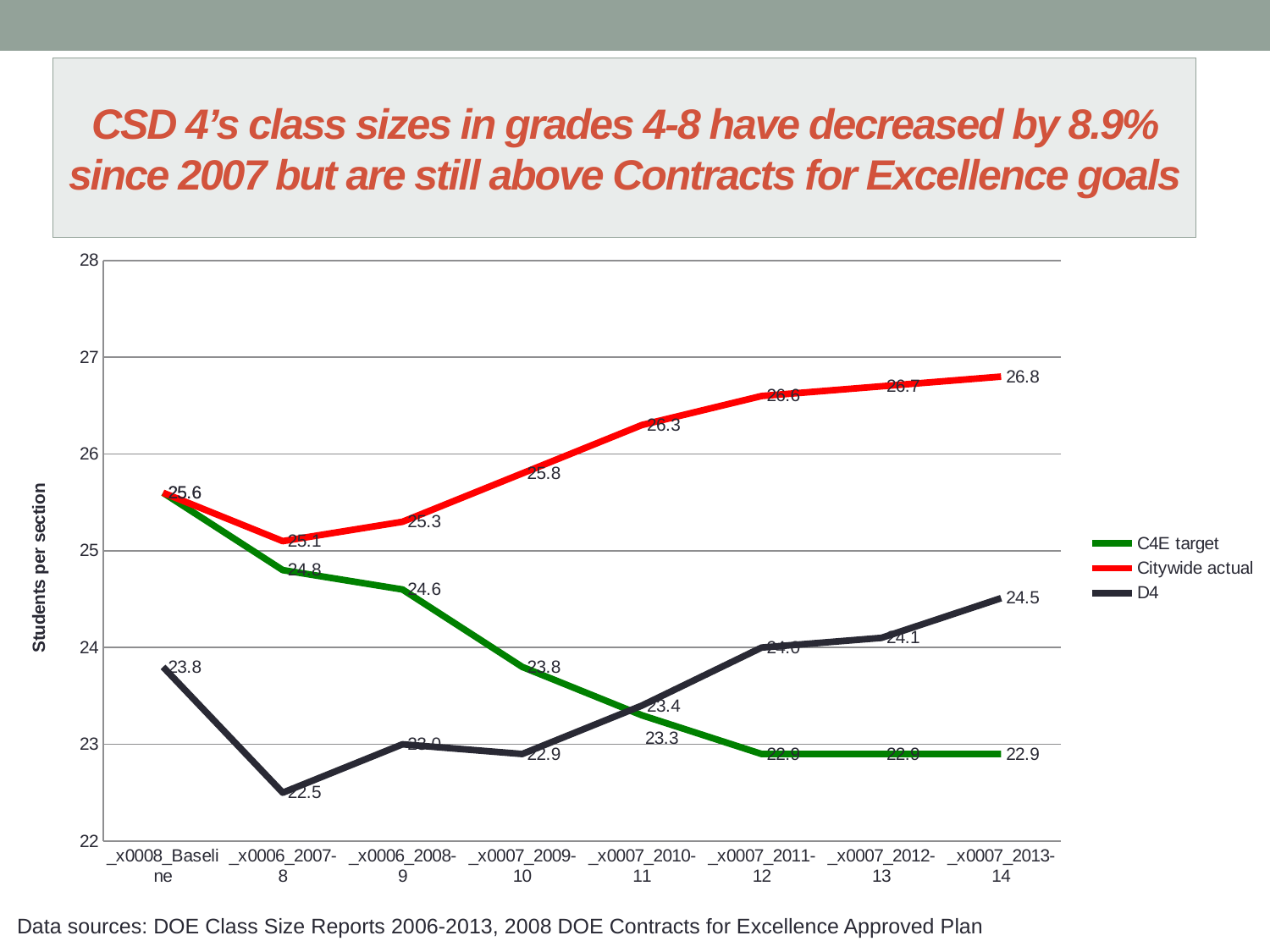
How many series does the legend list? 3 What is the C4E target value for 2013-14? 22.9 In which year is the D4 line at its lowest? 2007-8 What is the Citywide actual value for 2013-14? 26.8 What kind of chart is shown on the slide? line chart Which is larger in 2013-14, the D4 value or the C4E target value? D4 How many points along the x axis does each line have? 8 What is the title of the y axis? Students per section In which year is the Citywide actual line at its highest? 2013-14 What is the D4 value for 2007-8? 22.5 What is the difference between the Citywide actual and D4 values in 2013-14? 2.3 What is the D4 value for 2013-14? 24.5